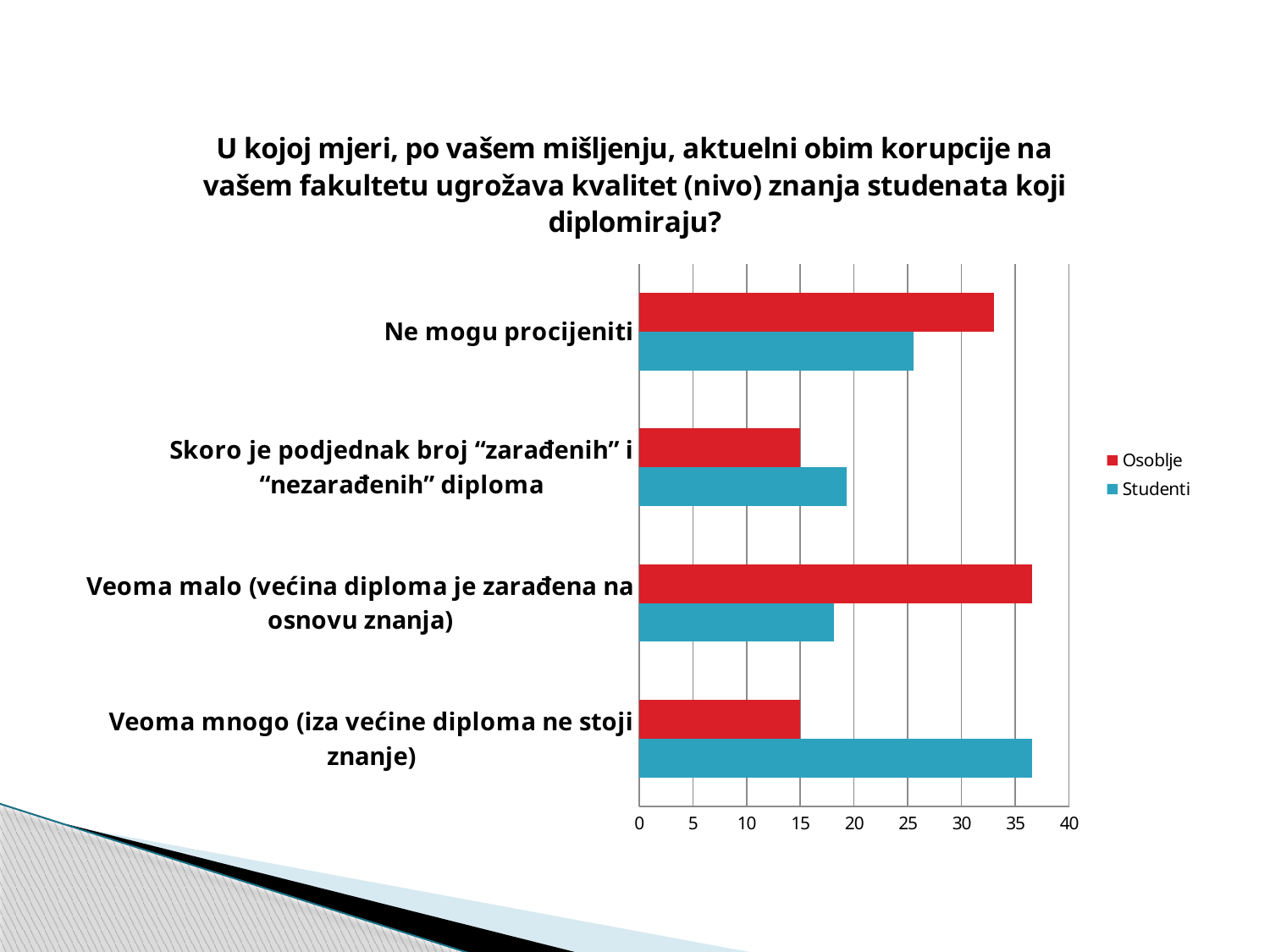
For 'Veoma mnogo (iza većine diploma ne stoji znanje)', which series has the larger value, Osoblje or Studenti? Studenti Is the Osoblje value for 'Ne mogu procijeniti' greater or less than 30? greater How many series does the legend list? 2 For the Studenti series, which category has the highest value? Veoma mnogo (iza većine diploma ne stoji znanje) Is the Osoblje value for 'Veoma malo (većina diploma je zarađena na osnovu znanja)' greater or less than 35? greater How many response categories are shown on the chart? 4 For the Osoblje series, which category has the highest value? Veoma malo (većina diploma je zarađena na osnovu znanja) What kind of chart is shown on the slide? bar chart What colour represents the Osoblje series? red Is the Studenti value for 'Veoma malo (većina diploma je zarađena na osnovu znanja)' greater or less than 20? less For the Osoblje series, which category has the lowest value? Veoma mnogo (iza većine diploma ne stoji znanje) and Skoro je podjednak broj “zarađenih” i “nezarađenih” diploma (tied at 15) For 'Ne mogu procijeniti', which series has the larger value, Osoblje or Studenti? Osoblje